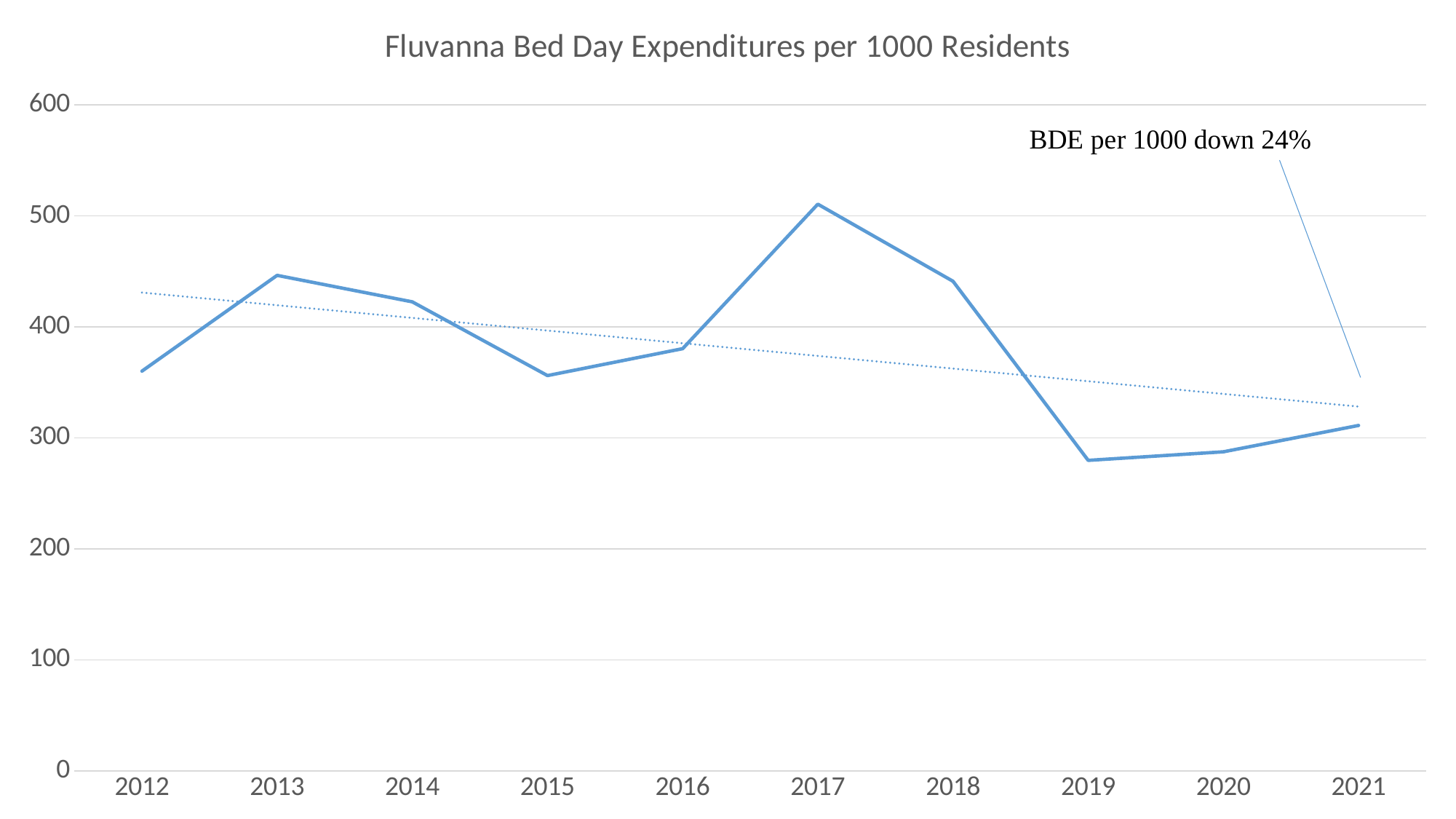
Which year has the highest bed day expenditures per 1000 residents? 2017 What is the title of the chart? Fluvanna Bed Day Expenditures per 1000 Residents Is the value for 2013 greater or less than 400? greater Does the dotted trend line rise or fall from 2012 to 2021? fall Is the value for 2019 greater or less than 300? less Is the value for 2012 greater or less than 400? less Which year has the larger value, 2012 or 2013? 2013 Which year has the larger value, 2018 or 2019? 2018 What kind of chart is shown on the slide? line chart How many years are plotted along the x axis? 10 What does the text annotation on the chart say? BDE per 1000 down 24%